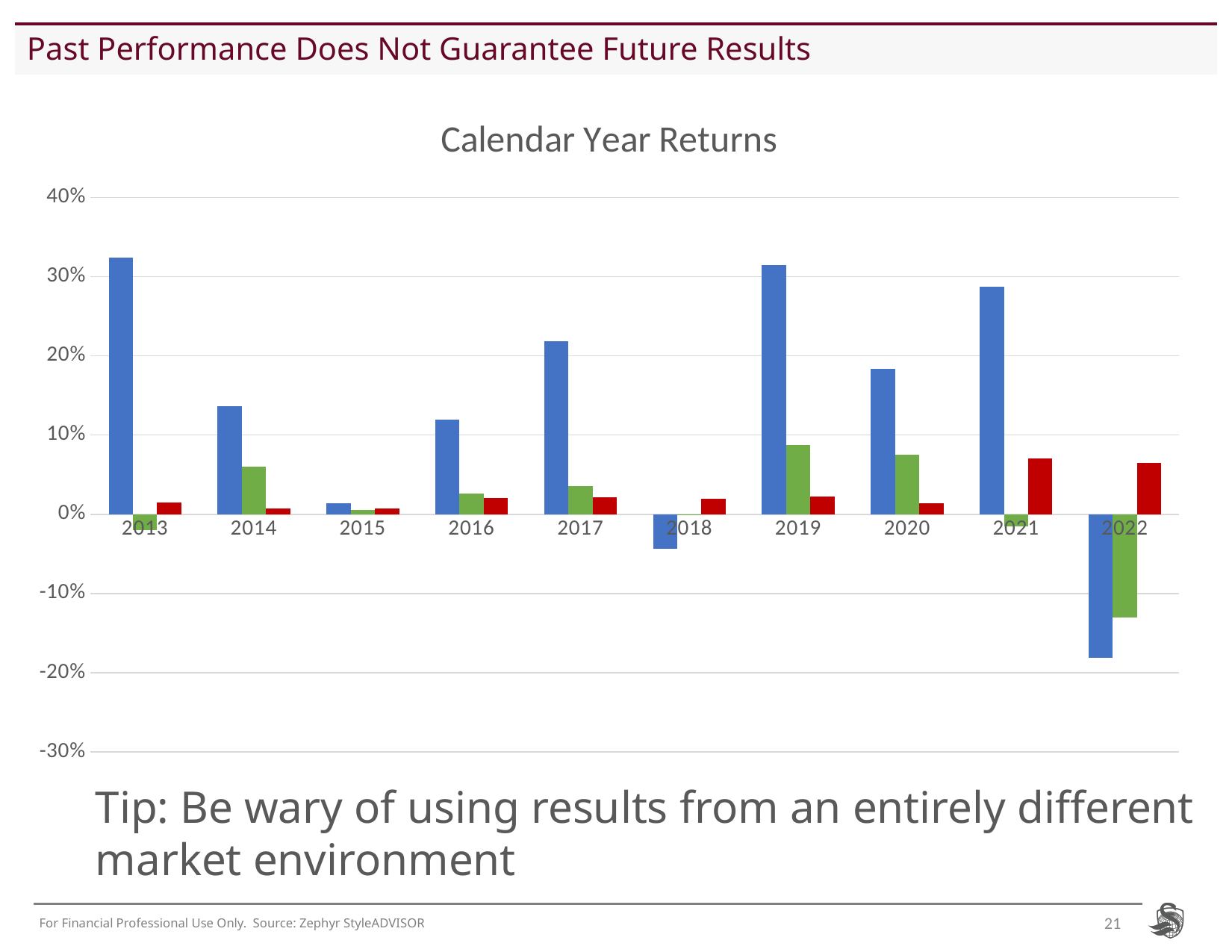
How many bars are plotted for each year in the chart? 3 What is the title of the chart? Calendar Year Returns Is the value of the green bar for 2022 greater or less than -10%? less Is the value of the blue bar for 2022 greater or less than -10%? less Which is larger, the blue bar for 2017 or the blue bar for 2020? 2017 In which year is the green bar lowest? 2022 Is the value of the blue bar for 2017 greater or less than 20%? greater What kind of chart is shown on the slide? bar chart Which is larger, the green bar for 2014 or the green bar for 2017? 2014 In which year is the blue bar lowest? 2022 How many years are shown on the x axis of the chart? 10